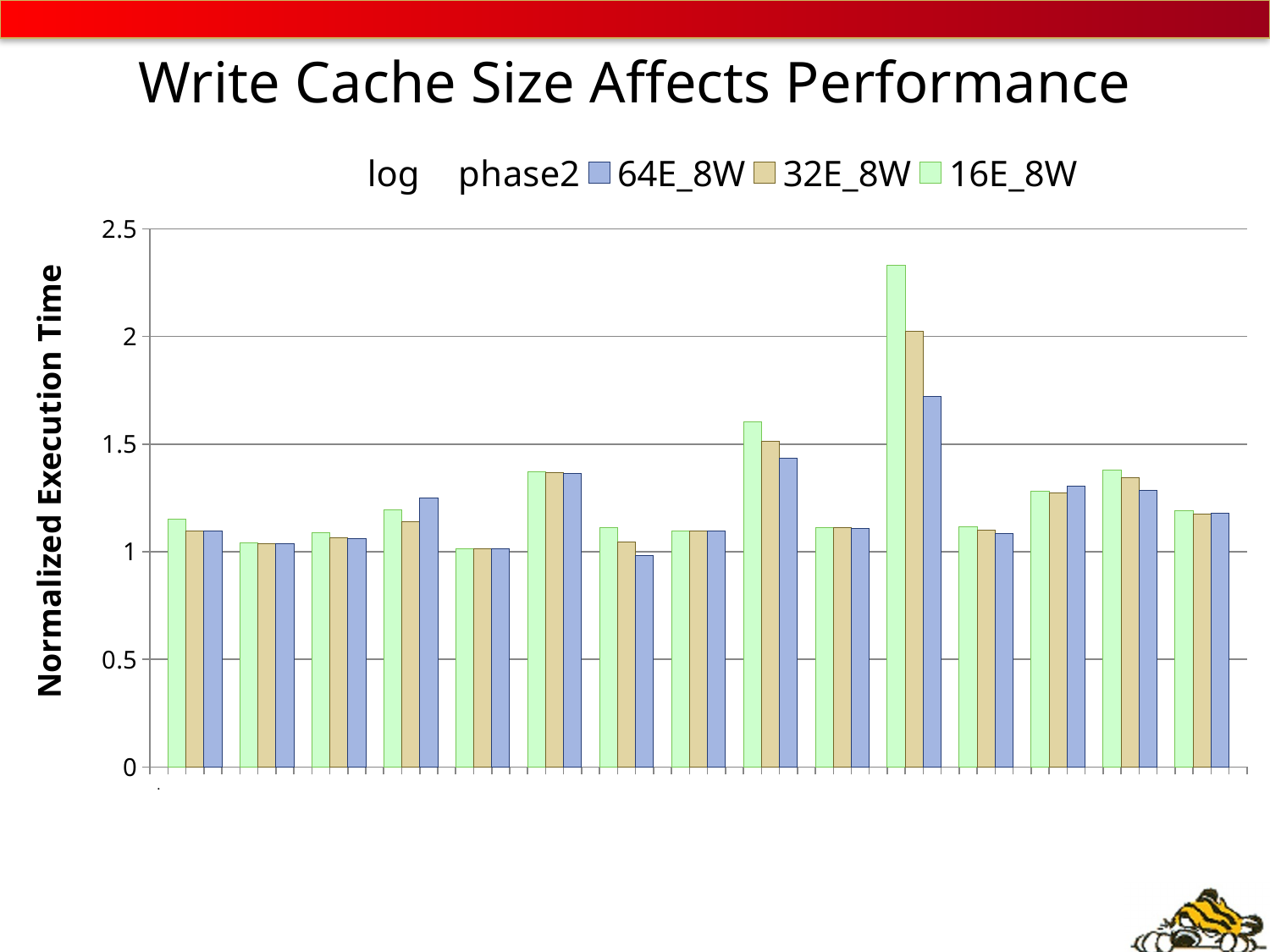
Which series is shown in light green in the legend? 16E_8W What kind of chart is shown on the slide? bar chart In the 11th group from the left, is the 64E_8W value greater or less than 2? less In the 9th group from the left, is the 64E_8W value greater or less than 1.5? less In the 9th group from the left, which is larger, the 16E_8W value or the 64E_8W value? 16E_8W In the tallest group of bars (the 11th group from the left), which series has the highest value? 16E_8W How many groups of bars are plotted along the x axis? 15 Is the value of the tallest 16E_8W bar greater or less than 2? greater What is the label of the y axis? Normalized Execution Time In the tallest group of bars (the 11th group from the left), which series has the lowest value? 64E_8W How many series does the legend list? 5